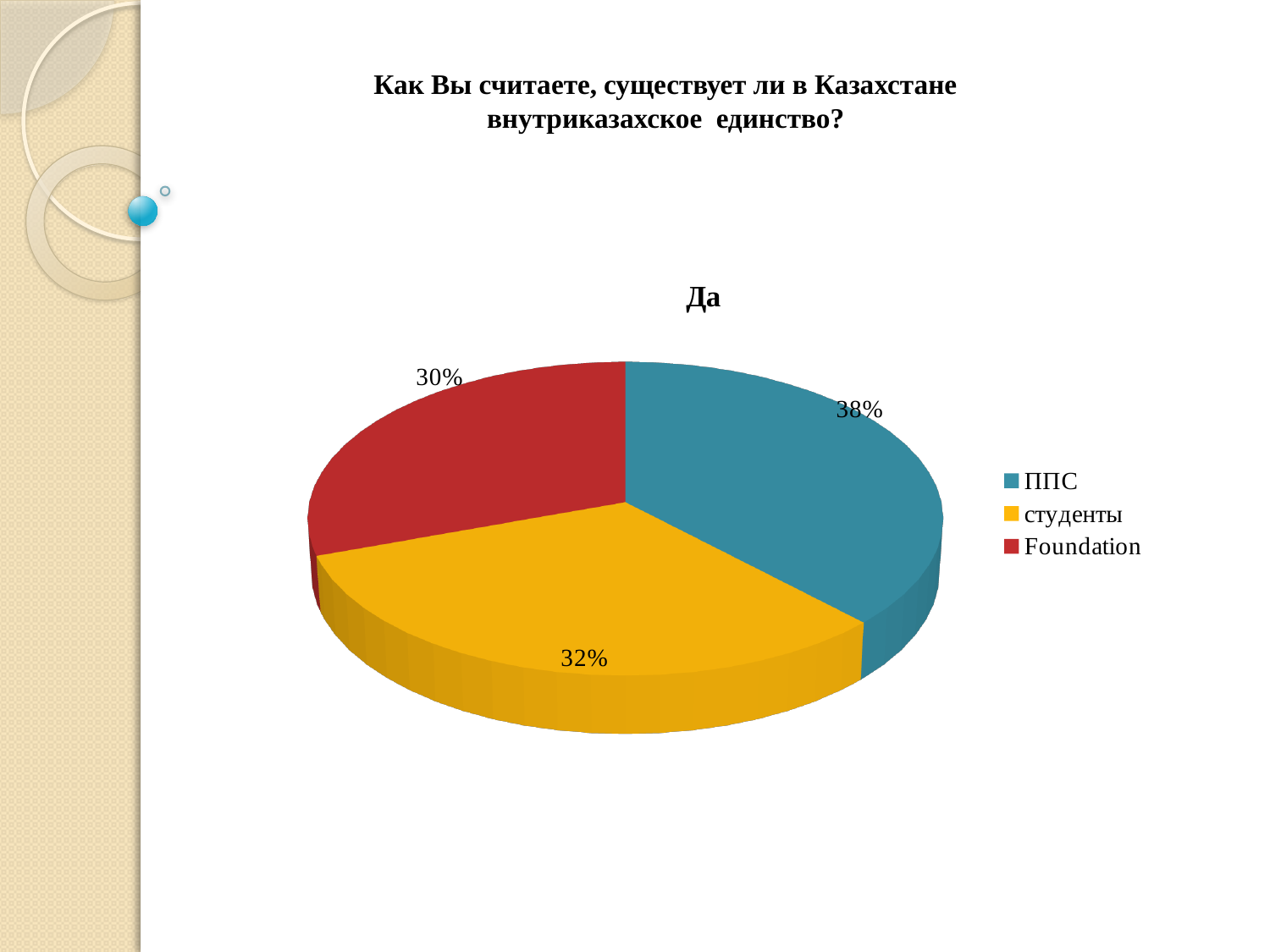
How many entries does the legend list? 3 Which category has the smallest slice of the pie? Foundation How many slices does the pie chart have? 3 What is the difference in percentage points between ППС and Foundation? 8 What is the title of the chart? Да Which is larger, the slice for студенты or the slice for Foundation? студенты What percentage is shown for студенты? 32% What kind of chart is shown on the slide? pie chart What percentage is shown for Foundation? 30% What colour is the slice for Foundation? red What percentage is shown for ППС? 38% Which category has the largest slice of the pie? ППС